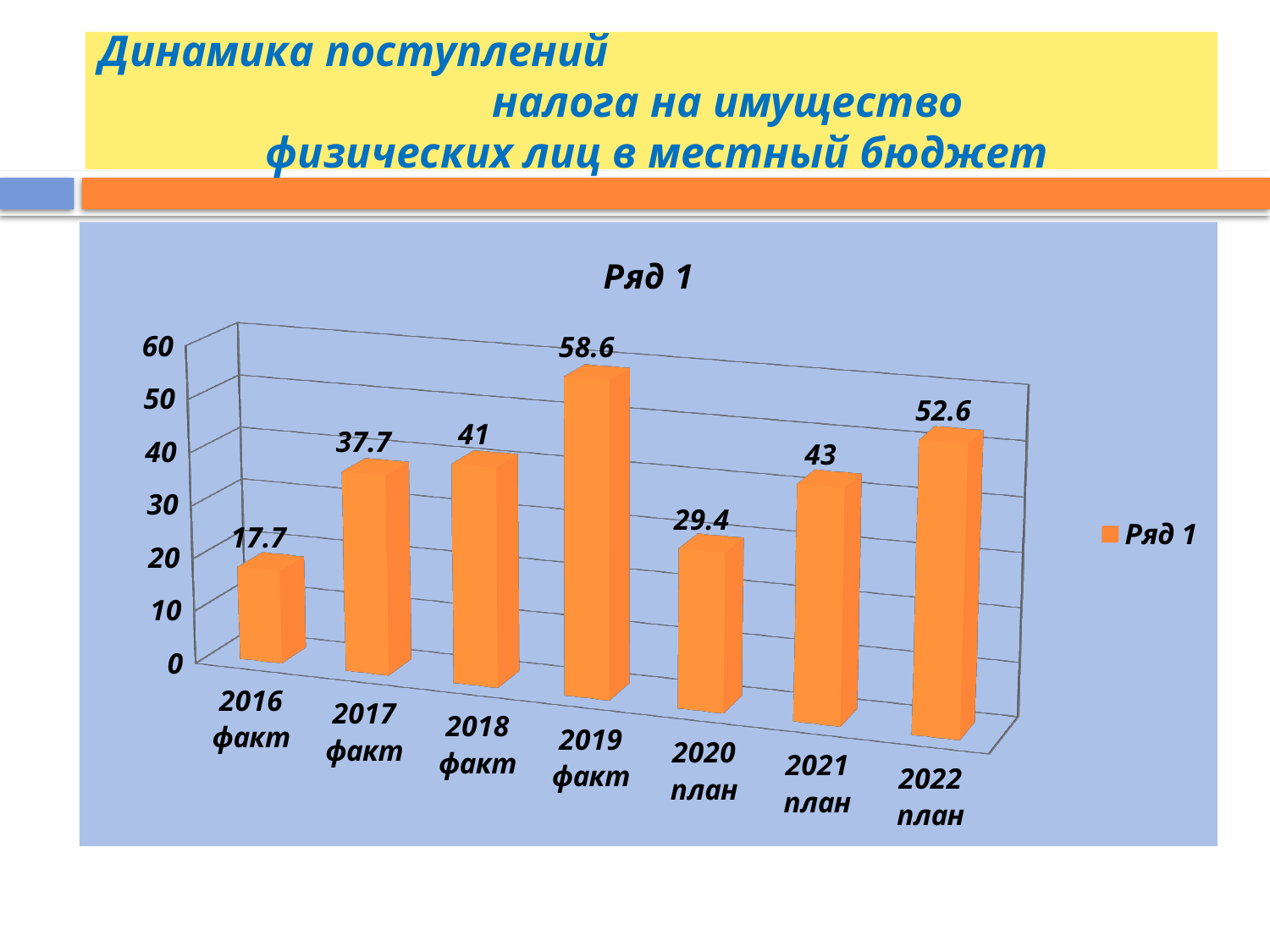
Which category has the lowest value? 2016 факт What is the value for 2022 план? 52.6 What is the value for 2019 факт? 58.6 Which is larger, the value for 2021 план or the value for 2018 факт? 2021 план What kind of chart is shown on the slide? bar chart What is the value for 2016 факт? 17.7 Which category has the highest value? 2019 факт How many categories are shown on the x axis? 7 How many series does the legend list? 1 What is the difference between the values for 2019 факт and 2020 план? 29.2 What is the title of the chart? Ряд 1 What is the value for 2020 план? 29.4